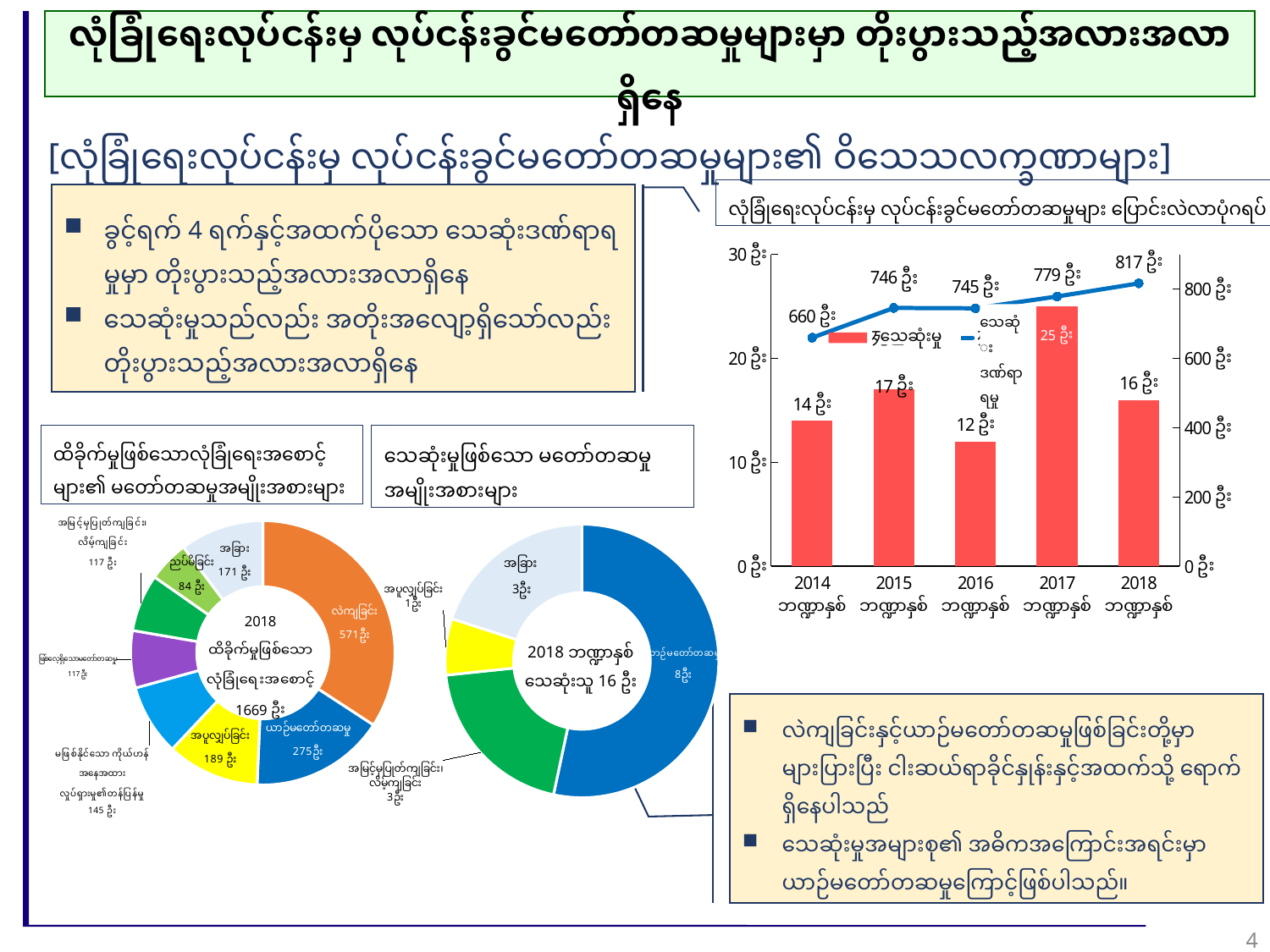
In the bottom-left donut chart (ထိခိုက်မှုဖြစ်သောလုံခြုံရေးအစောင့်များ၏ မတော်တဆမှုအမျိုးအစားများ), what is the value for လဲကျခြင်း? 571 ဦး In the top-right chart (လုံခြုံရေးလုပ်ငန်းမှ လုပ်ငန်းခွင်မတော်တဆမှုများ ပြောင်းလဲလာပုံဂရပ်), what is the value of the red bar for 2017 ဘဏ္ဍာနှစ်? 25 ဦး In the top-right chart, which year has the lowest red bar? 2016 ဘဏ္ဍာနှစ် In the top-right chart, which year has the highest red bar? 2017 ဘဏ္ဍာနှစ် In the top-right chart, does the blue line generally rise or fall from 2014 to 2018? rise In the top-right chart, what is the difference between the blue line values for 2018 and 2014? 157 ဦး In the bottom-middle donut chart (သေဆုံးမှုဖြစ်သော မတော်တဆမှုအမျိုးအစားများ), what is the value for ယာဉ်မတော်တဆမှု? 8 ဦး In the top-right chart, is the blue line value for 2015 larger or smaller than for 2016? larger In the top-right chart, how many years are shown on the x axis? 5 In the top-right chart, what is the value of the blue line for 2018 ဘဏ္ဍာနှစ်? 817 ဦး In the top-right chart, what kind of chart is used? Combined bar and line chart In the bottom-left donut chart, what is the total shown in the centre for 2018? 1669 ဦး